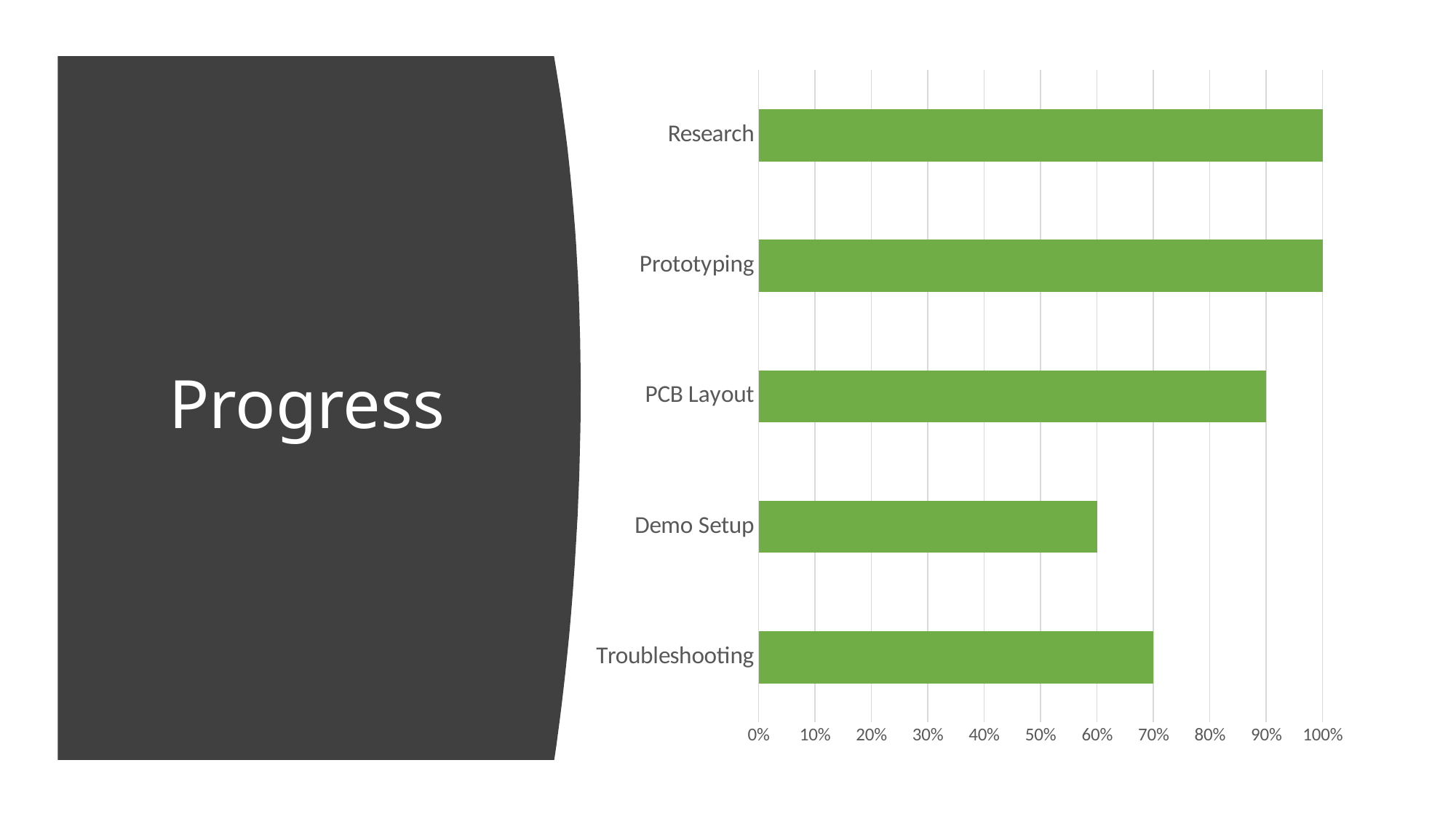
What is the value for PCB Layout? 90% Which category has the lowest value? Demo Setup What is the difference between the values for Prototyping and Troubleshooting? 30% What is the value for Troubleshooting? 70% What colour are the bars in the chart? green What is the difference between the values for PCB Layout and Demo Setup? 30% What kind of chart is shown on the slide? bar chart Is the value for PCB Layout greater or less than 80%? greater How many categories are shown in the chart? 5 Which is larger, the value for Troubleshooting or the value for Demo Setup? Troubleshooting What is the value for Research? 100% What is the value for Demo Setup? 60%